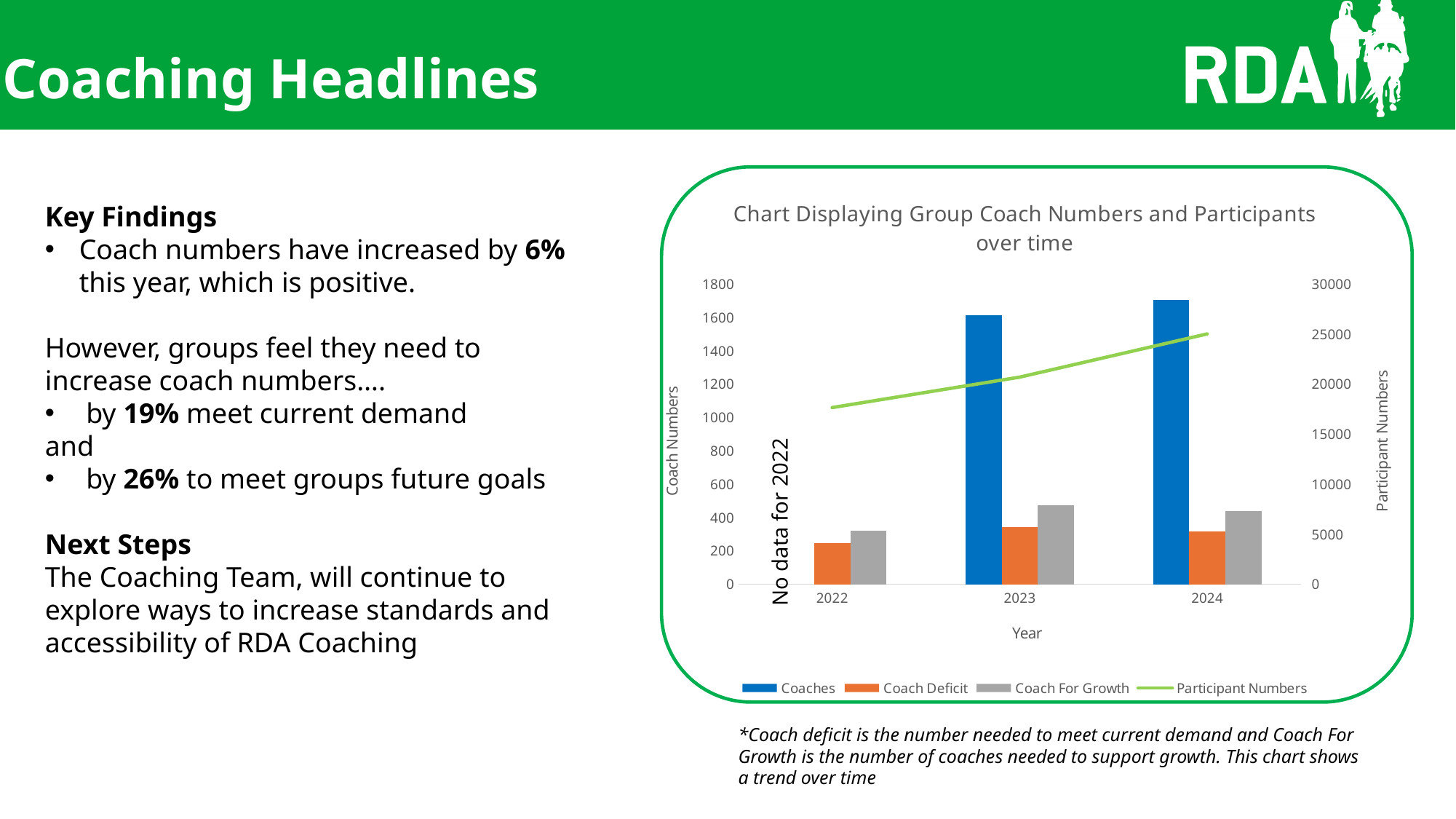
Is the Coach Deficit value for 2022 greater or less than 400? less What kind of chart is shown on the slide? A combined bar and line chart Is the Coaches value for 2023 greater or less than 1400? greater Does the Participant Numbers line rise or fall from 2022 to 2024? Rises What is the label of the right-hand vertical axis of the chart? Participant Numbers How many series does the chart legend list? 4 Which is larger in 2023: Coach Deficit or Coach For Growth? Coach For Growth Is the Participant Numbers value for 2024 greater or less than 20000? greater Which year has the highest Coaches bar? 2024 How many years are shown on the x axis of the chart? 3 Which year has no Coaches data according to the chart? 2022